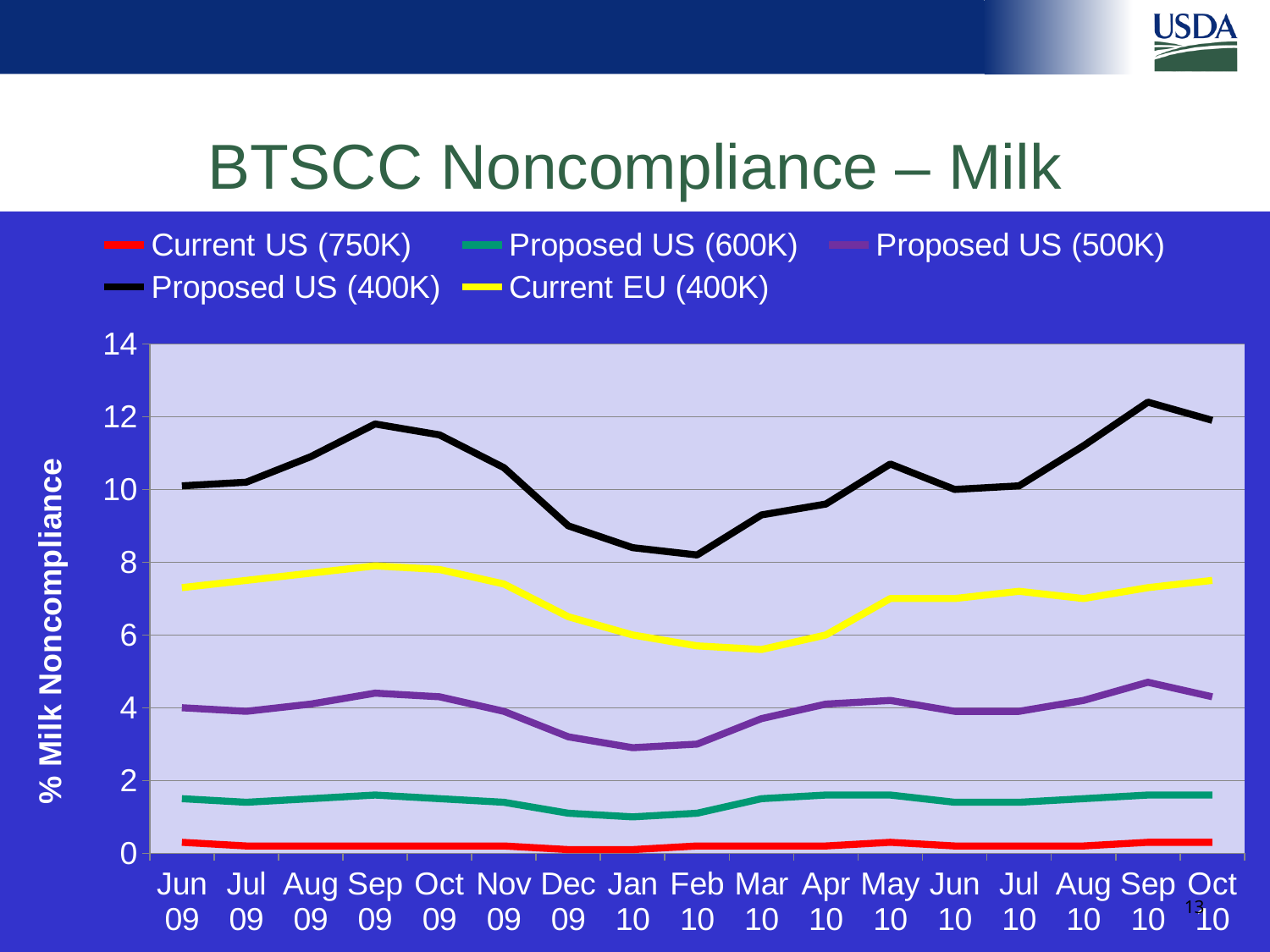
How many series does the legend list? 5 Which series has the highest values across the whole chart? Proposed US (400K) What is the label on the y axis? % Milk Noncompliance For the Proposed US (400K) series, in which month is the value highest? Sep 10 Which is larger for Proposed US (400K): the value in Sep 09 or the value in Jan 10? Sep 09 Does the Proposed US (400K) line rise or fall from Sep 09 to Feb 10? Fall Is the value for Current EU (400K) in Mar 10 greater or less than 6? less What kind of chart is shown on the slide? Line chart How many months are plotted along the x axis? 17 Is the value for Proposed US (500K) in Jan 10 greater or less than 4? less Is the value for Proposed US (400K) in Sep 10 greater or less than 12? greater Which series has the lowest values across the whole chart? Current US (750K)